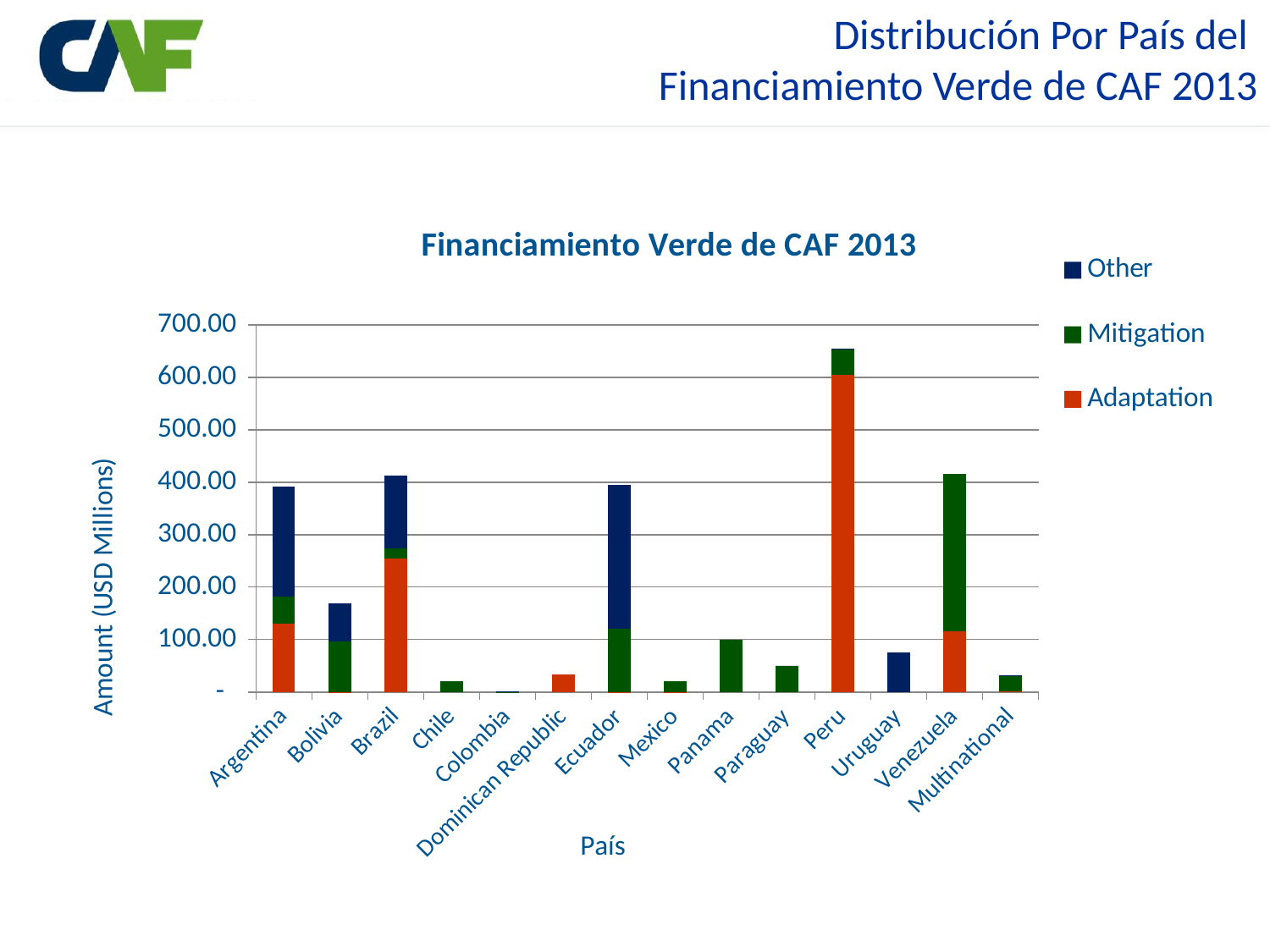
How many countries/categories are shown on the x axis of the chart? 14 Which has a larger total bar, Venezuela or Bolivia? Venezuela What is the label of the y axis of the chart? Amount (USD Millions) What is the title of the chart? Financiamiento Verde de CAF 2013 Which country has the lowest total bar in the chart? Colombia Is the total value for Venezuela greater or less than 400? greater Is the total value for Peru greater or less than 600? greater Which country has the largest Mitigation segment in the chart? Venezuela What kind of chart is shown on the slide? Stacked bar chart Which country has the highest total bar in the chart? Peru Is the total value for Uruguay greater or less than 100? less How many series does the chart legend list? 3